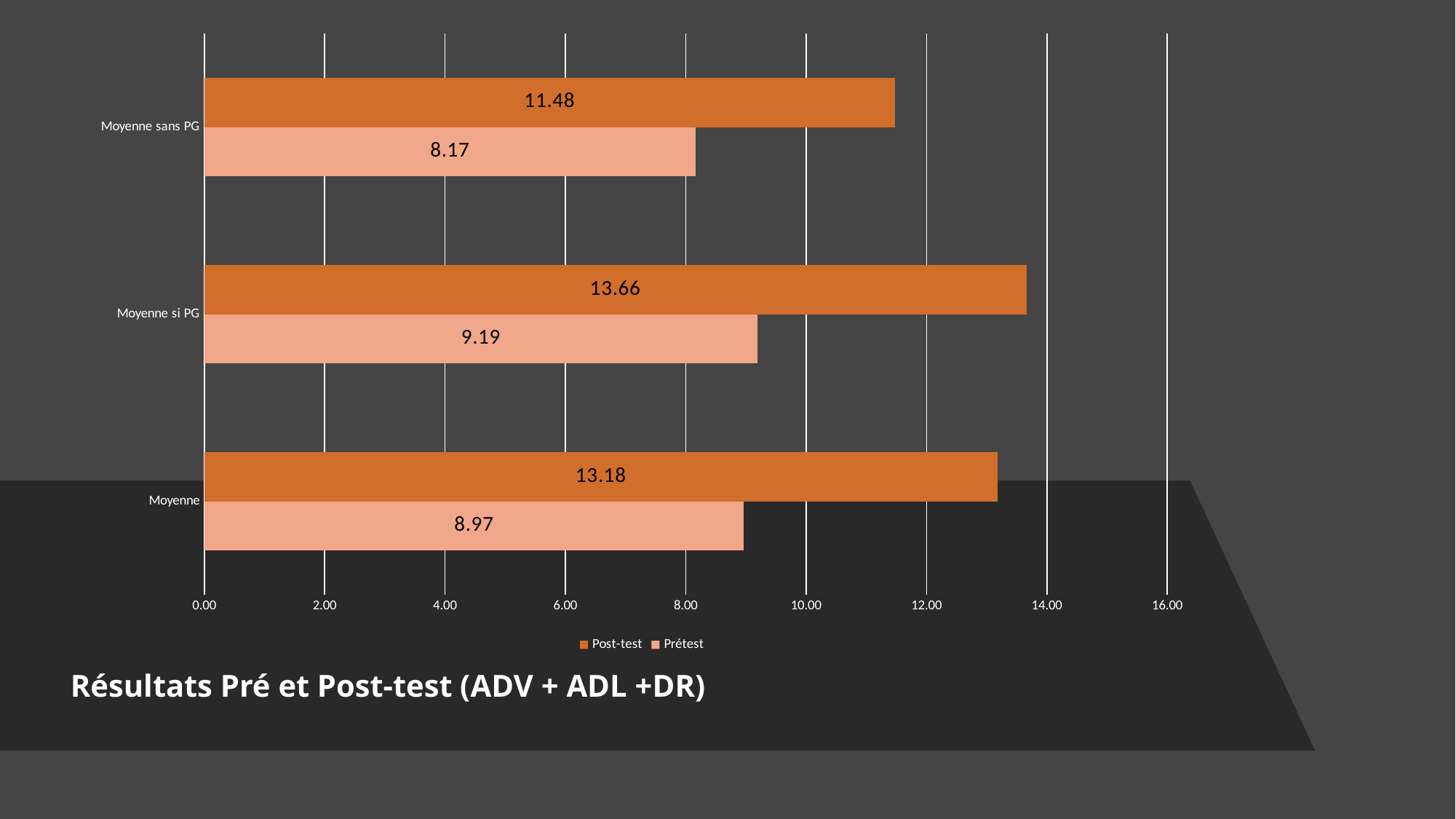
How many series does the legend list? 2 Which category has the highest Post-test value? Moyenne si PG Which is larger: the Prétest value for Moyenne si PG or the Prétest value for Moyenne? Moyenne si PG How many categories are shown on the chart? 3 What is the difference between the Post-test and Prétest values for Moyenne si PG? 4.47 What is the Prétest value for Moyenne? 8.97 What kind of chart is shown on the slide? Bar chart What is the Prétest value for Moyenne sans PG? 8.17 What is the Post-test value for Moyenne sans PG? 11.48 What is the difference between the Post-test values for Moyenne si PG and Moyenne sans PG? 2.18 What is the Post-test value for Moyenne si PG? 13.66 Which category has the lowest Prétest value? Moyenne sans PG